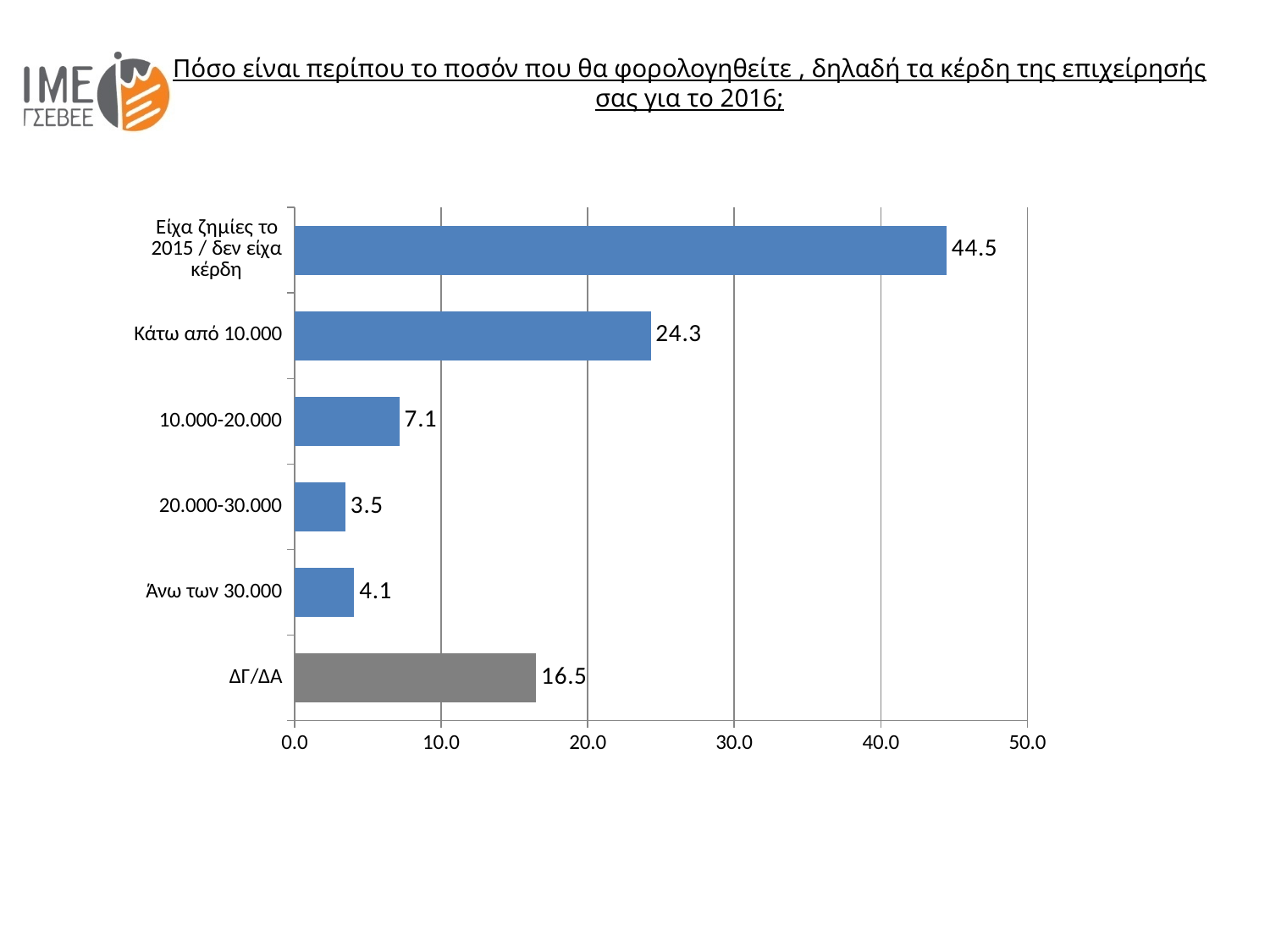
What is the value for '20.000-30.000'? 3.5 Which bar is coloured differently (grey) from the others? ΔΓ/ΔΑ What is the difference between the values for 'Είχα ζημίες το 2015 / δεν είχα κέρδη' and 'Κάτω από 10.000'? 20.2 Which is larger, the value for '10.000-20.000' or the value for 'Άνω των 30.000'? 10.000-20.000 Which category has the lowest value? 20.000-30.000 How many categories are shown in the chart? 6 What is the value for 'ΔΓ/ΔΑ'? 16.5 What is the difference between the values for 'Άνω των 30.000' and '20.000-30.000'? 0.6 What is the value for 'Κάτω από 10.000'? 24.3 What kind of chart is shown on the slide? bar chart Which category has the highest value? Είχα ζημίες το 2015 / δεν είχα κέρδη Is the value for 'ΔΓ/ΔΑ' greater or less than 20.0? less